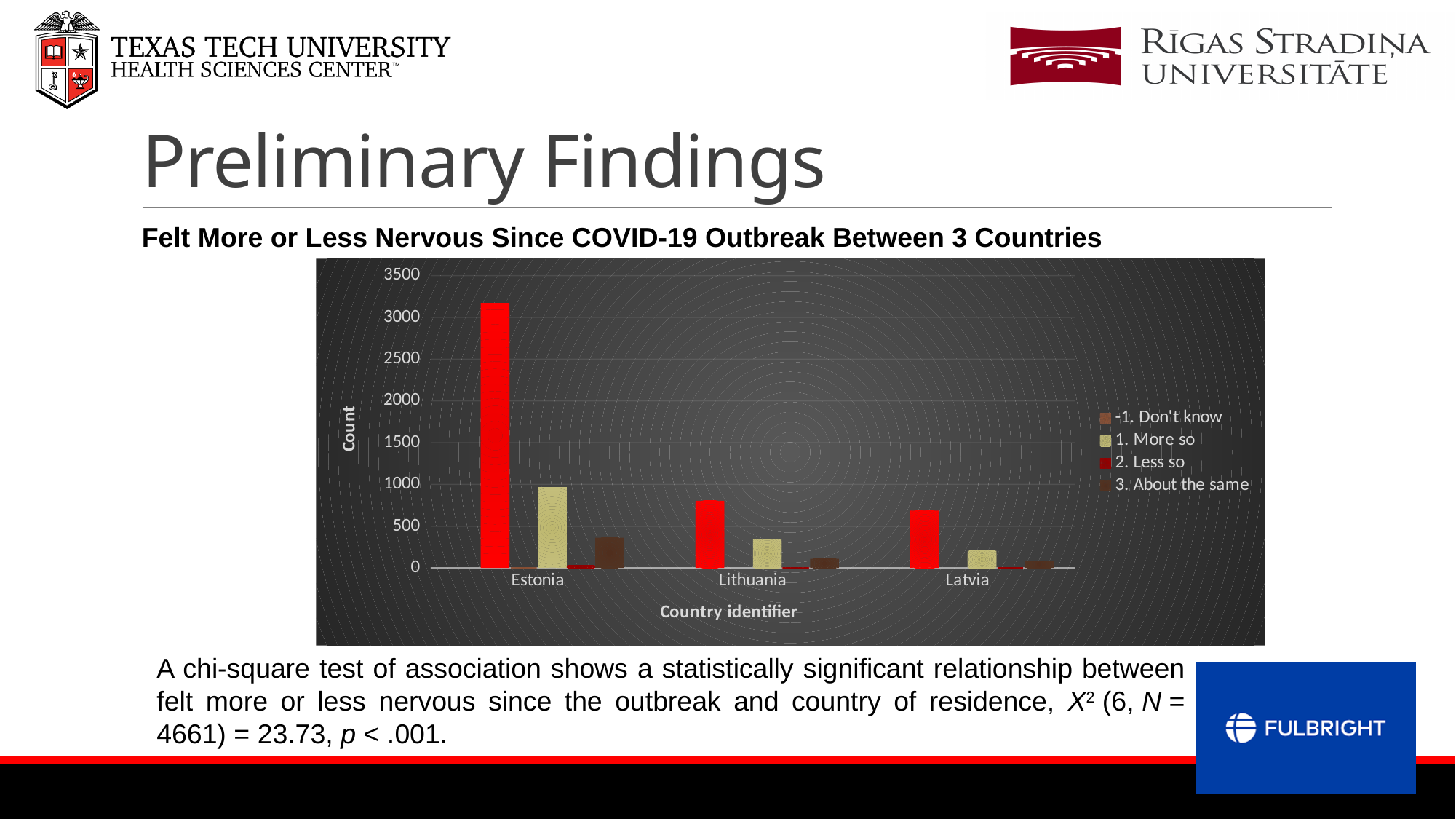
How many series does the chart's legend list? 4 Is the value of the tallest bar for Lithuania greater or less than 1000? less Do the tallest bars rise or fall moving from Estonia to Lithuania to Latvia along the x axis? Fall Is the value of the tallest bar for Latvia greater or less than 500? greater What is the title of the chart's x axis? Country identifier What is the title of the chart's y axis? Count Which country has the tallest bar in the chart? Estonia How many countries are shown on the x axis of the chart? 3 What is the highest value shown on the chart's y axis? 3500 Is the value of the tallest bar for Estonia greater or less than 3000? greater Which country has the larger tallest bar, Lithuania or Latvia? Lithuania What kind of chart is shown on the slide? Bar chart